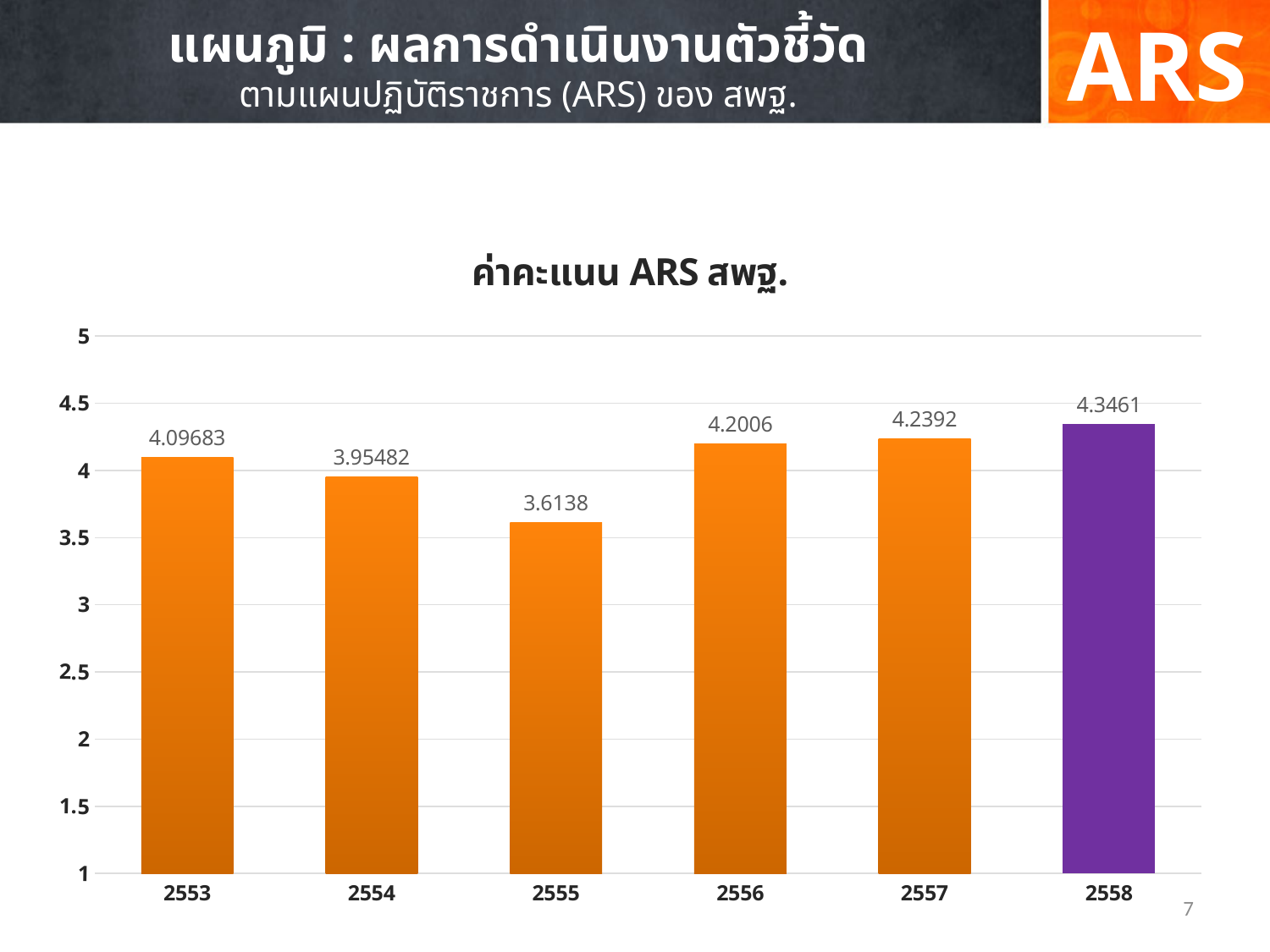
How many years are shown on the x axis of the chart? 6 Which year has the highest value in the chart? 2558 What kind of chart is shown on the slide? bar chart What is the value for 2555 in the chart? 3.6138 Which year has the lowest value in the chart? 2555 Is the value for 2555 greater or less than 4? less Which is larger, the value for 2553 or the value for 2554? 2553 From 2555 to 2558, do the values rise or fall? rise What is the difference between the values for 2558 and 2557? 0.1069 What is the value for 2558 in the chart? 4.3461 What is the difference between the values for 2556 and 2555? 0.5868 What is the value for 2553 in the chart? 4.09683